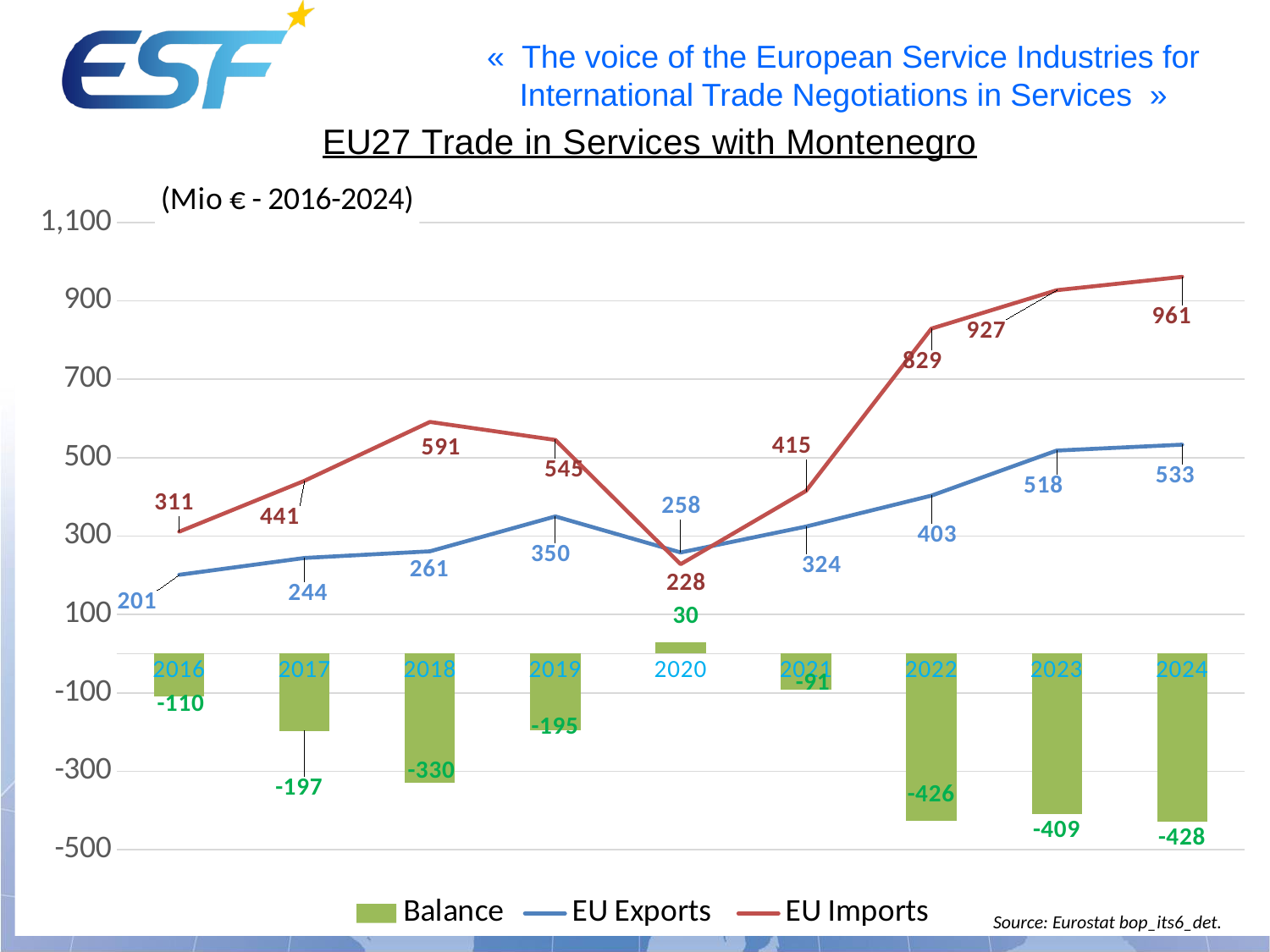
What is the value of EU Imports in 2024? 961 In which year are EU Exports highest? 2024 How many series does the legend list? 3 What is the Balance value for 2020? 30 What is the difference between EU Imports and EU Exports in 2023? 409 Is the value of EU Imports in 2022 greater or less than 700? greater What is the title of the chart? EU27 Trade in Services with Montenegro In which year are EU Imports lowest? 2020 Do EU Imports rise or fall from 2020 to 2024? rise Which is larger in 2020, EU Exports or EU Imports? EU Exports How many years are shown on the x axis? 9 What is the value of EU Exports in 2019? 350